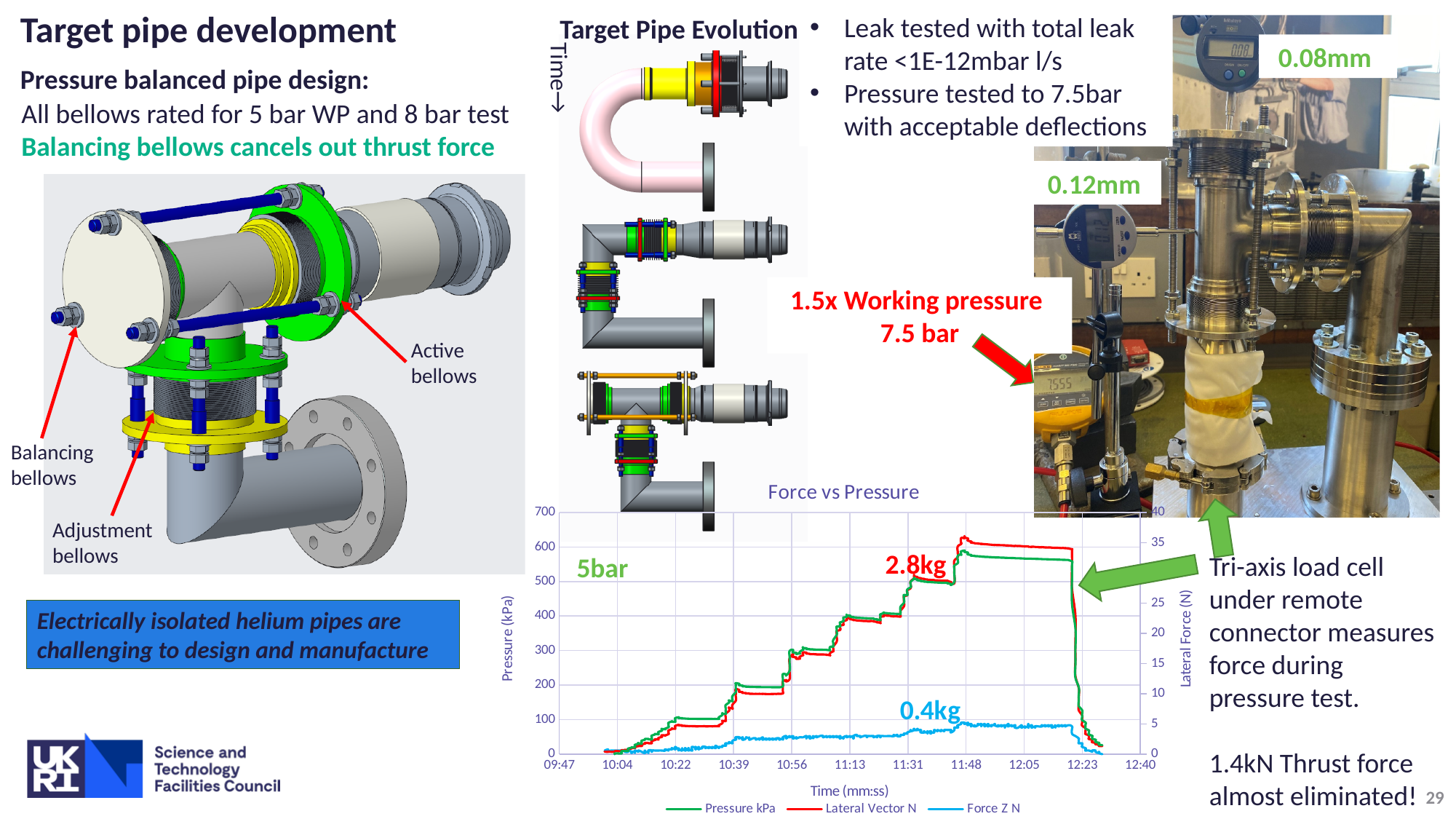
What is the title of the chart at the bottom centre of the slide? Force vs Pressure In the Force vs Pressure chart, is the Pressure kPa value at 10:39 greater or less than 100? greater In the Force vs Pressure chart, does the Pressure kPa series generally rise or fall between 10:04 and 11:48? rise In the Force vs Pressure chart, which series stays lowest across the whole time range? Force Z N In the Force vs Pressure chart, is the Force Z N value at 11:48 greater or less than 10 on the right axis? less What kind of chart is the Force vs Pressure chart? line chart In the Force vs Pressure chart, which series is drawn in blue according to the legend? Force Z N In the Force vs Pressure chart, is the Pressure kPa value at 11:13 greater or less than 300? greater In the Force vs Pressure chart, at 11:31 which series is plotted higher, Lateral Vector N or Force Z N? Lateral Vector N How many time labels are shown along the x axis of the Force vs Pressure chart? 11 How many series does the legend of the Force vs Pressure chart list? 3